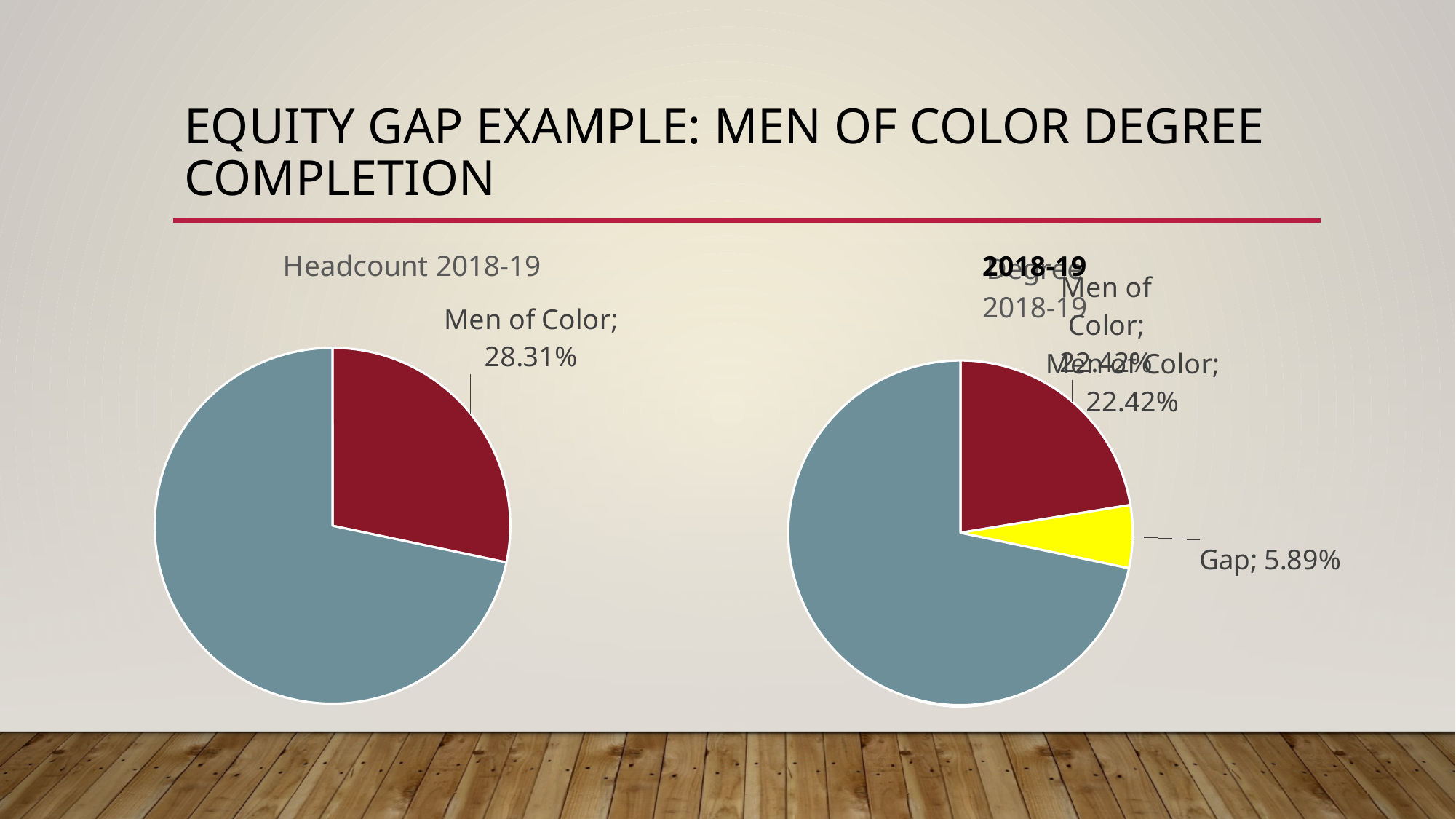
What kind of chart is the right chart on the slide? Pie chart What is the difference between the Men of Color share in the left chart (28.31%) and the Men of Color share in the right chart (22.42%)? 5.89% In the right pie chart, what colour is the Gap slice? Yellow How many slices does the left pie chart titled "Headcount 2018-19" have? 2 In the right pie chart, which labeled slice is smaller, Men of Color or Gap? Gap What is the title of the left pie chart? Headcount 2018-19 What kind of chart is the left chart titled "Headcount 2018-19"? Pie chart In the right pie chart, what percentage is shown for the Gap slice? 5.89% In the left pie chart titled "Headcount 2018-19", what percentage is shown for Men of Color? 28.31% In the right pie chart, what percentage is shown for Men of Color? 22.42% Which is larger: the Men of Color share in the left "Headcount 2018-19" chart or the Men of Color share in the right chart? Left chart (Headcount 2018-19) How many slices does the right pie chart have? 3